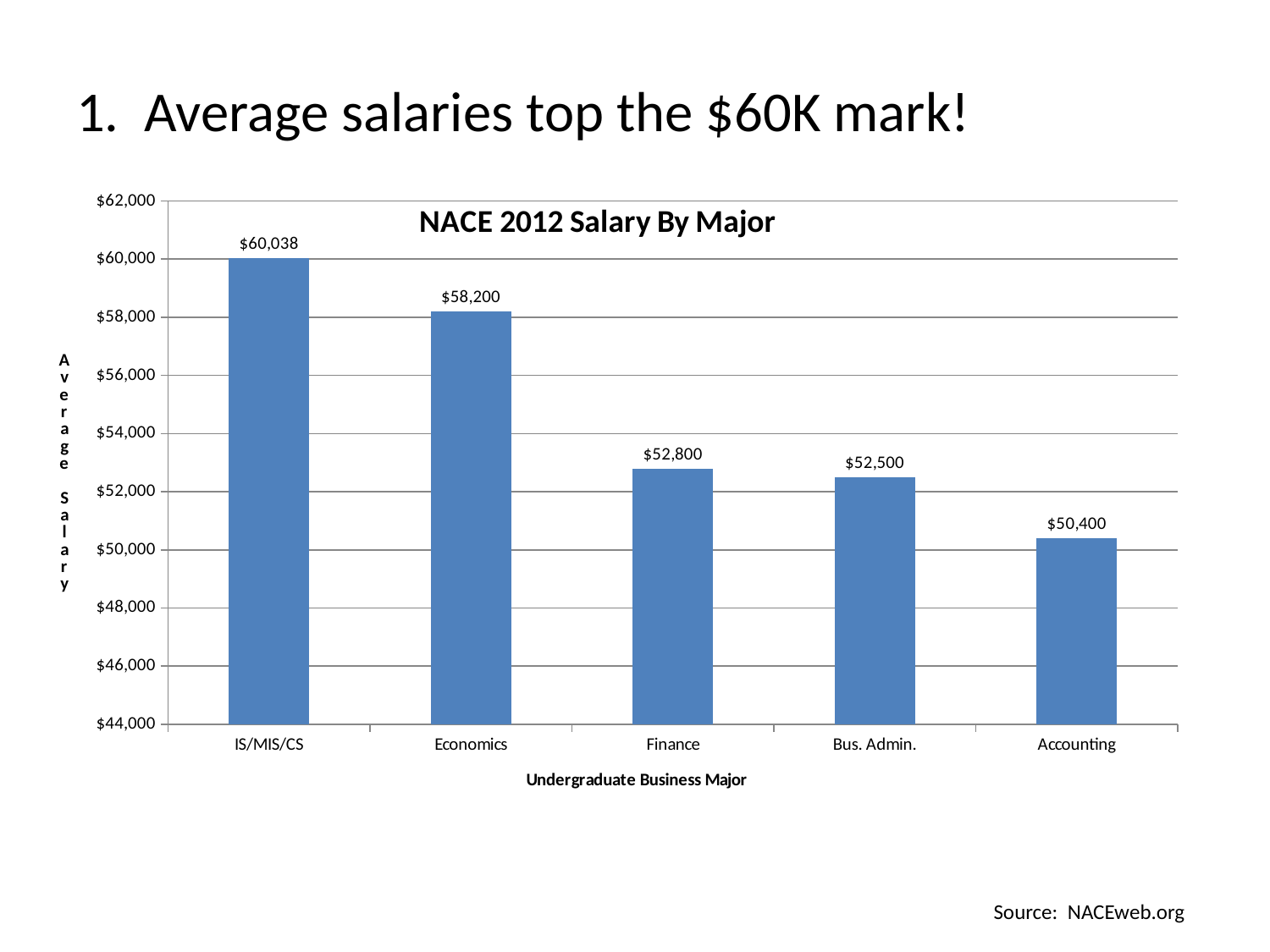
What is the difference between the average salaries for IS/MIS/CS and Accounting? $9,638 Is the value for Bus. Admin. greater or less than $54,000? less What is the average salary for Finance? $52,800 What is the difference between the average salaries for Economics and Bus. Admin.? $5,700 Which major has the highest average salary? IS/MIS/CS What is the average salary for Accounting? $50,400 How many majors are shown in the chart? 5 What is the title of the chart? NACE 2012 Salary By Major What is the average salary for IS/MIS/CS? $60,038 Which has a higher average salary, Economics or Finance? Economics Which major has the lowest average salary? Accounting What kind of chart is shown on the slide? bar chart